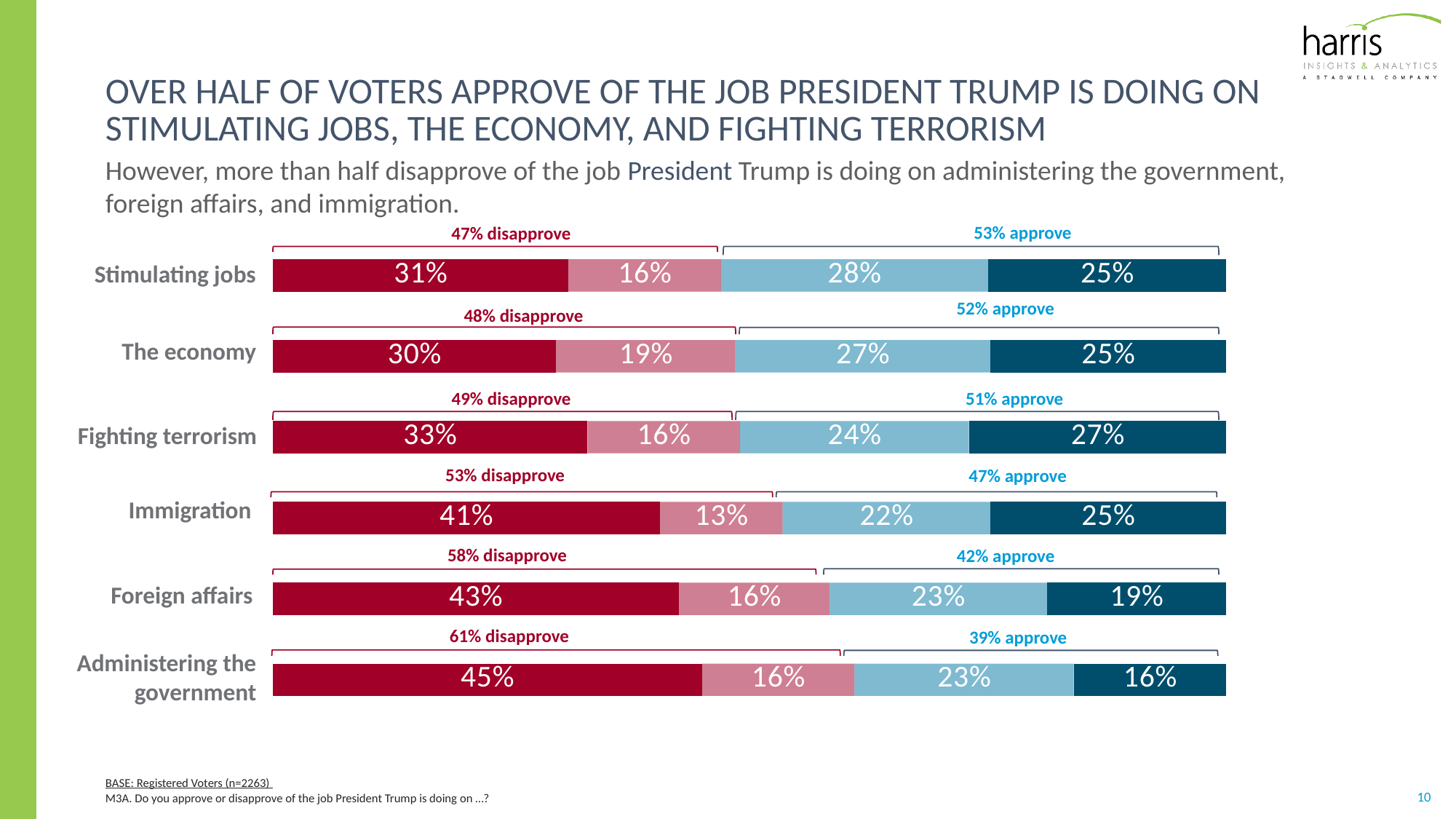
What is the value of the leftmost (dark red) segment for Immigration? 41% Which category has the lowest value in the rightmost (dark blue) segment? Administering the government How many categories (issues) are shown in the chart? 6 What is the total of the two blue (approve) segments for Foreign affairs? 42% What total approve percentage is shown for Stimulating jobs? 53% approve Which category has the highest value in the leftmost (dark red) segment? Administering the government Which category has the highest approve total shown above its bar? Stimulating jobs Which is larger: the light blue segment for Stimulating jobs or the light blue segment for Immigration? Stimulating jobs What total disapprove percentage is shown for Administering the government? 61% disapprove What kind of chart is shown on the slide? stacked bar chart What is the value of the rightmost (dark blue) segment for Fighting terrorism? 27% What is the difference between the dark red segment values for Foreign affairs and The economy? 13%